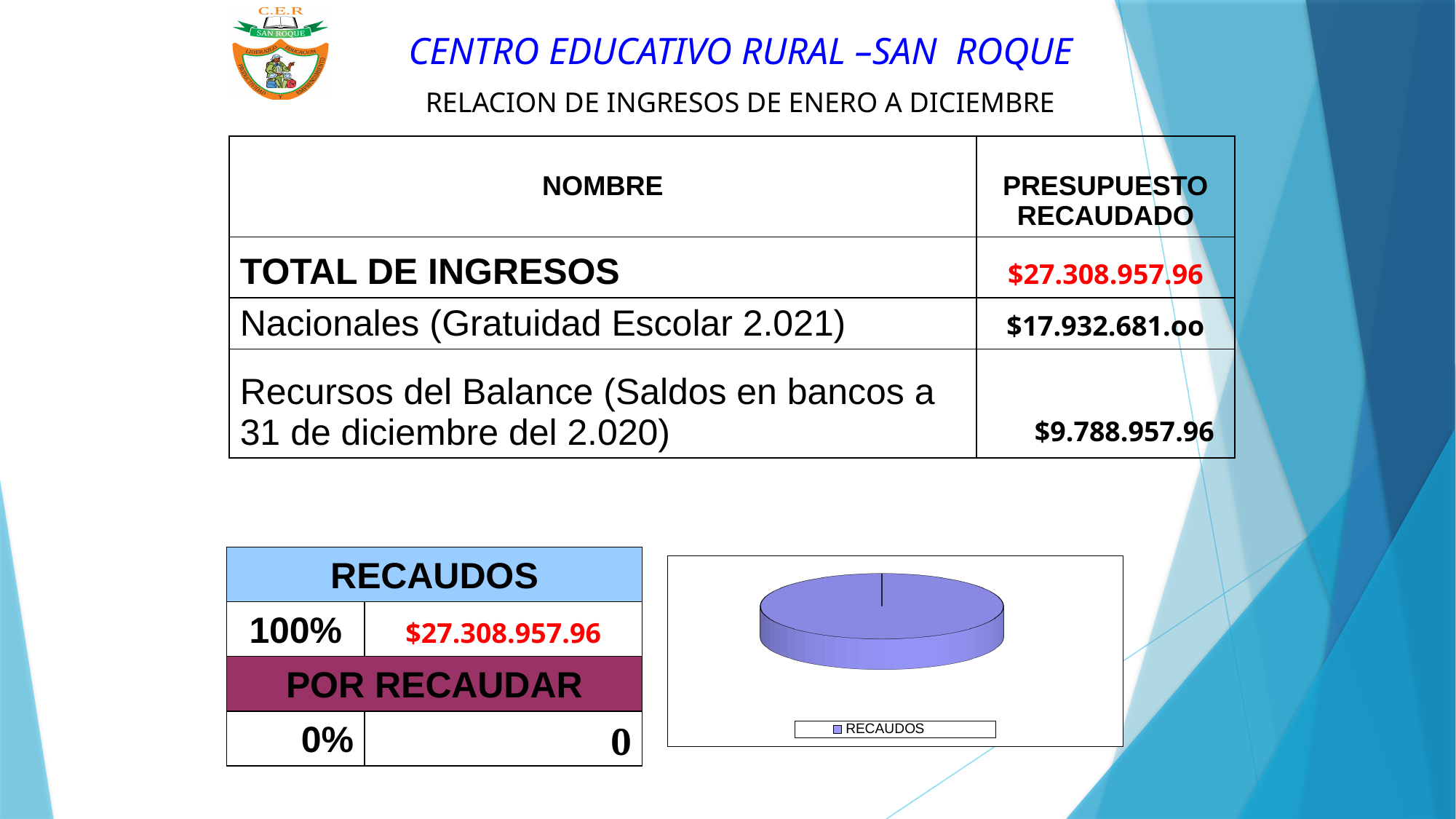
What kind of chart is shown at the bottom right of the slide? Pie chart What is the name of the only entry in the pie chart's legend? RECAUDOS What colour is the RECAUDOS slice in the pie chart? Light purple/blue How many entries does the legend of the pie chart list? 1 How many slices does the pie chart contain? 1 What share of the pie chart does the RECAUDOS slice take up? 100%